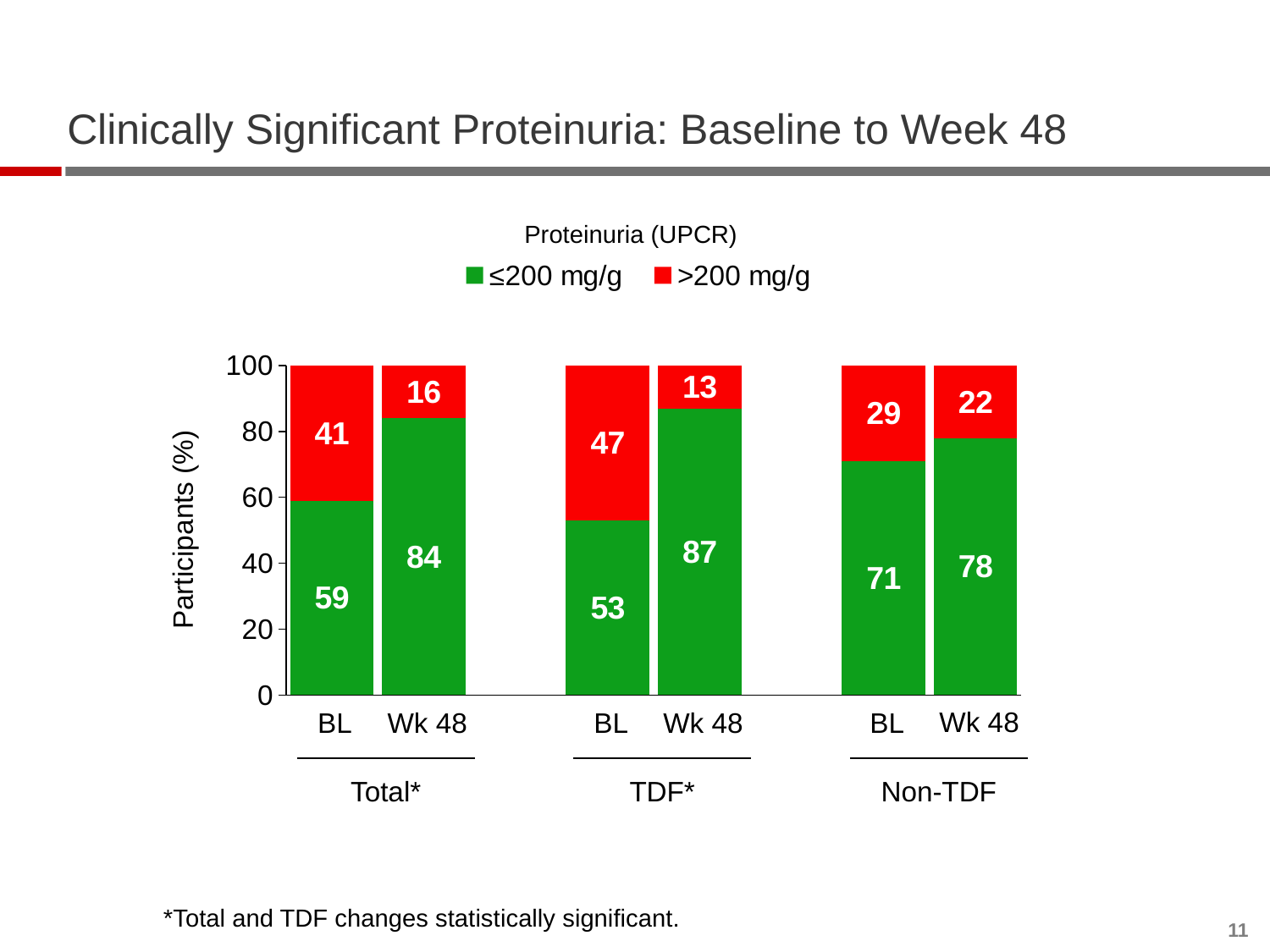
How many bars are plotted in the chart? 6 Which is larger: the ≤200 mg/g share at Wk 48 in the TDF group or in the Non-TDF group? TDF What is the total of the stacked bar for TDF at BL? 100 What percentage of participants in the TDF group had proteinuria >200 mg/g at BL? 47 How many series does the legend list? 2 What kind of chart is shown on the slide? stacked bar chart What percentage of participants in the Non-TDF group had proteinuria >200 mg/g at Wk 48? 22 What percentage of participants in the Non-TDF group had proteinuria ≤200 mg/g at BL? 71 Which bar has the lowest percentage of participants with proteinuria >200 mg/g? TDF Wk 48 What percentage of participants in the Total group had proteinuria ≤200 mg/g at Wk 48? 84 Which bar has the highest percentage of participants with proteinuria ≤200 mg/g? TDF Wk 48 By how many percentage points did the >200 mg/g share in the Total group change from BL to Wk 48? 25